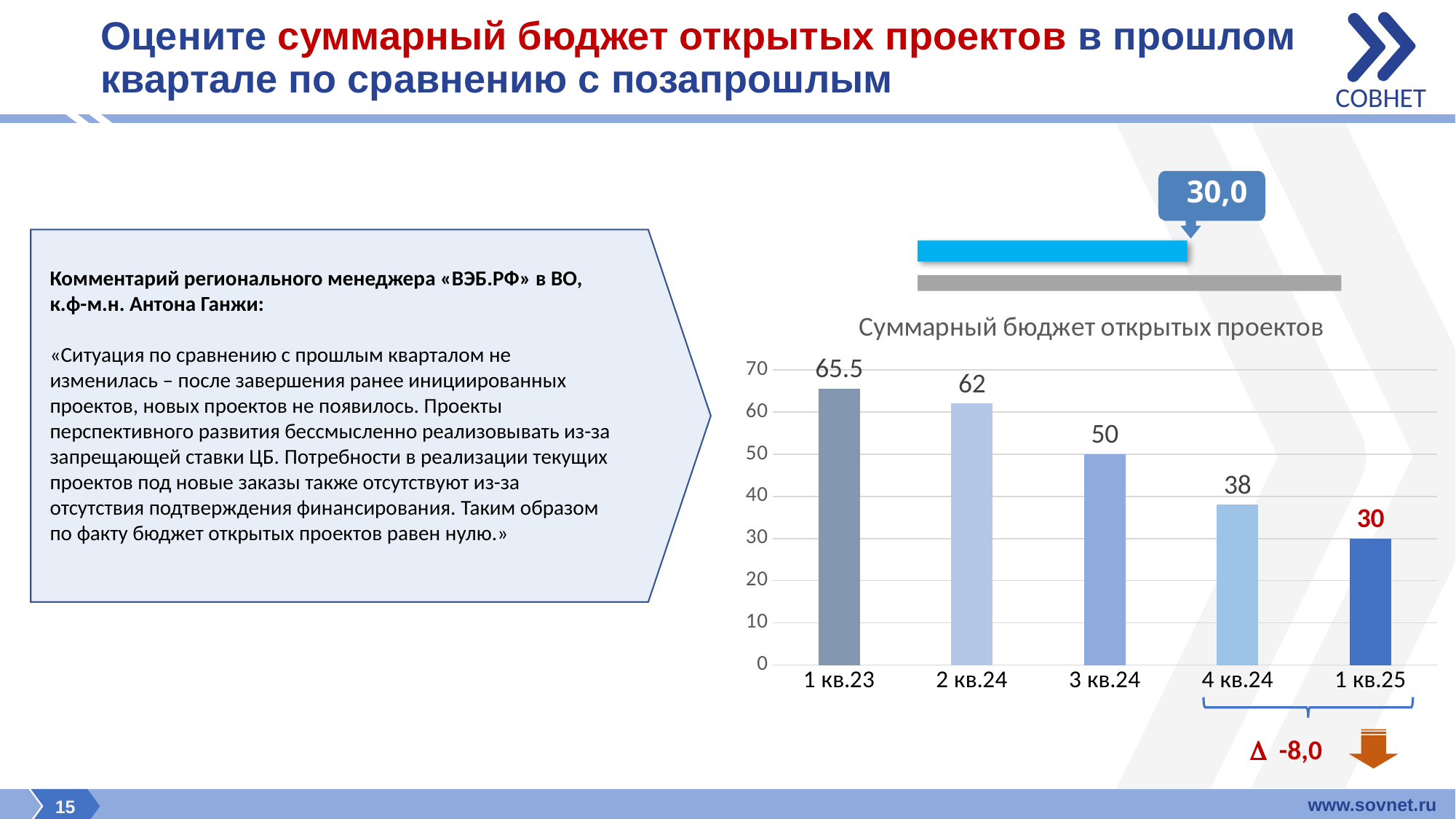
Do the values rise or fall from left to right along the x axis? fall Which category has the lowest value in the chart? 1 кв.25 Which category has the highest value in the chart? 1 кв.23 What is the difference between the values for 4 кв.24 and 1 кв.25? 8 How many categories are shown on the x axis of the chart? 5 What is the value for 1 кв.25 in the chart? 30 What is the title of the chart? Суммарный бюджет открытых проектов What kind of chart is shown on the slide? bar chart What is the value for 1 кв.23 in the chart? 65.5 What is the difference between the values for 2 кв.24 and 3 кв.24? 12 Which is larger, the value for 2 кв.24 or the value for 4 кв.24? 2 кв.24 What is the value for 3 кв.24 in the chart? 50